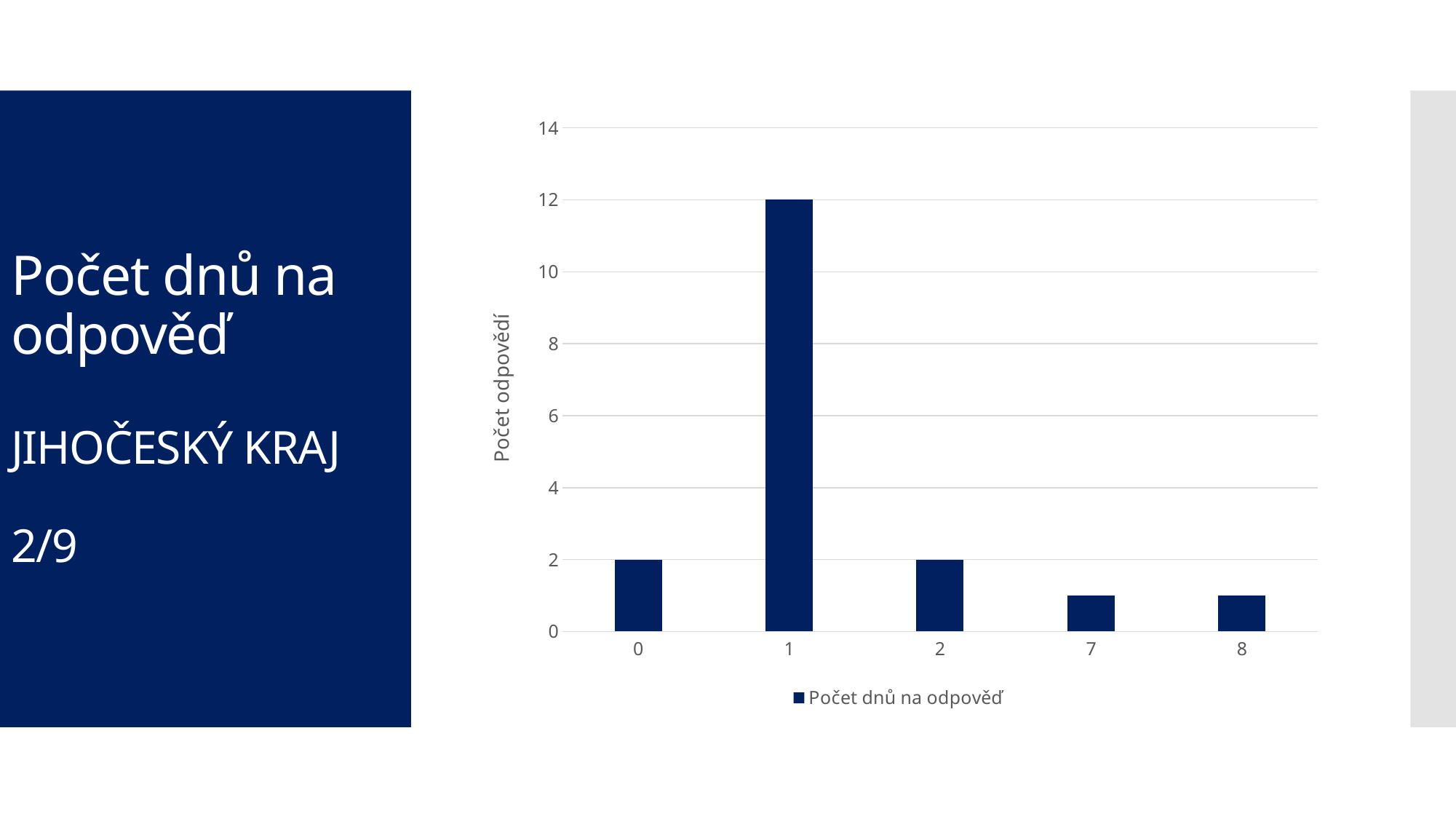
What is the difference between the values for category 1 and category 0? 10 What is the value for category 0 in the chart? 2 Is the value for category 7 greater or less than 2? less What is the value for category 1 in the chart? 12 How many series does the chart legend list? 1 What type of chart is shown on the slide? bar chart Which category has the highest value in the chart? 1 Is the value for category 8 greater or less than 2? less How many categories are shown on the x axis of the chart? 5 Which is larger, the value for category 1 or the value for category 2? 1 What is the value for category 2 in the chart? 2 What is the legend entry of the series in the chart? Počet dnů na odpověď